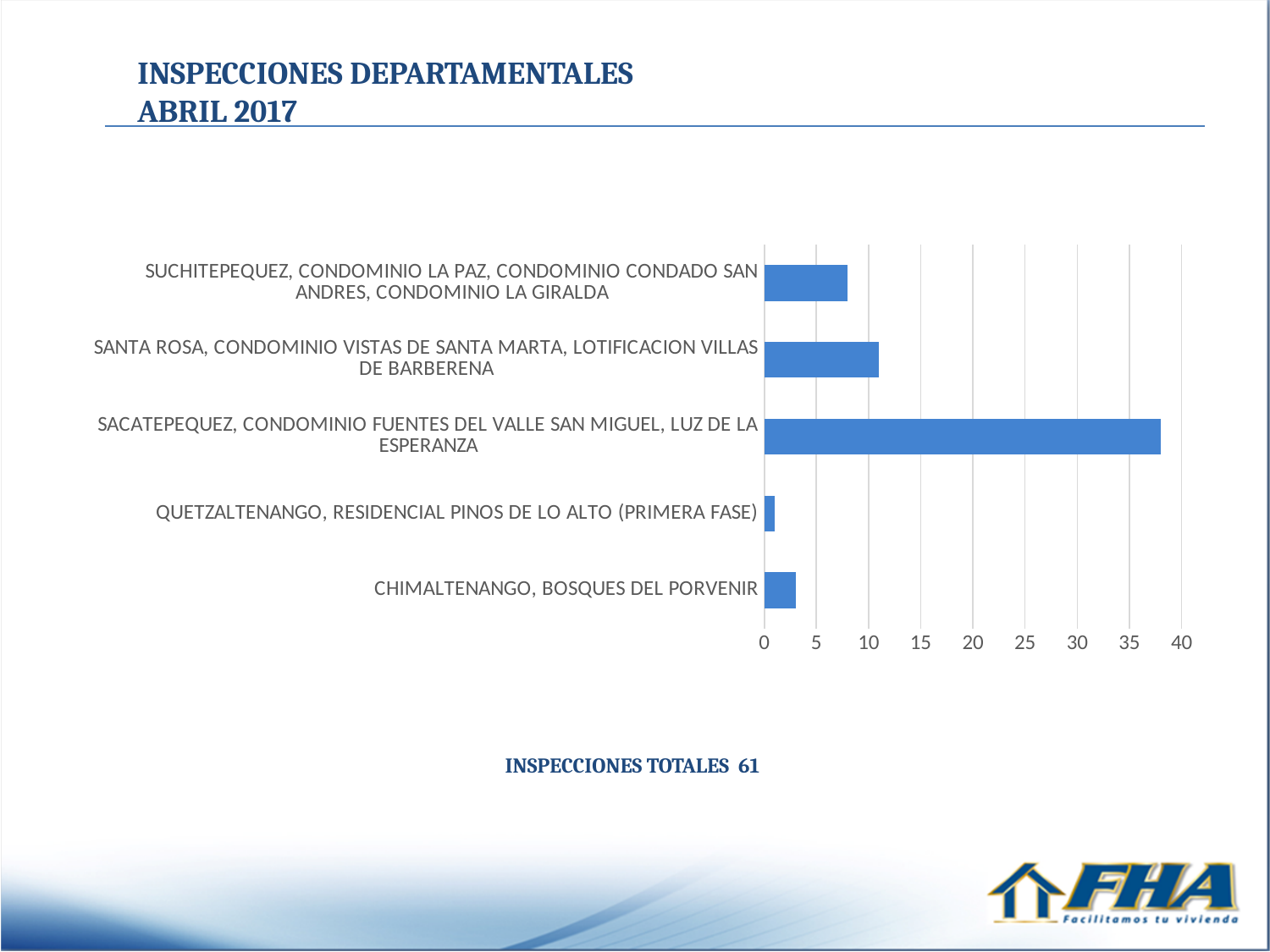
What total number of inspections is stated below the chart? 61 Which has a larger value: CHIMALTENANGO, BOSQUES DEL PORVENIR or QUETZALTENANGO, RESIDENCIAL PINOS DE LO ALTO (PRIMERA FASE)? CHIMALTENANGO, BOSQUES DEL PORVENIR Is the value for SACATEPEQUEZ, CONDOMINIO FUENTES DEL VALLE SAN MIGUEL, LUZ DE LA ESPERANZA greater or less than 35? greater Which category has the lowest value in the chart? QUETZALTENANGO, RESIDENCIAL PINOS DE LO ALTO (PRIMERA FASE) What is the title of the slide containing the chart? INSPECCIONES DEPARTAMENTALES ABRIL 2017 Is the value for CHIMALTENANGO, BOSQUES DEL PORVENIR greater or less than 5? less Which category has the highest value in the chart? SACATEPEQUEZ, CONDOMINIO FUENTES DEL VALLE SAN MIGUEL, LUZ DE LA ESPERANZA Which has a larger value: SANTA ROSA, CONDOMINIO VISTAS DE SANTA MARTA, LOTIFICACION VILLAS DE BARBERENA or SUCHITEPEQUEZ, CONDOMINIO LA PAZ, CONDOMINIO CONDADO SAN ANDRES, CONDOMINIO LA GIRALDA? SANTA ROSA, CONDOMINIO VISTAS DE SANTA MARTA, LOTIFICACION VILLAS DE BARBERENA Is the value for SUCHITEPEQUEZ, CONDOMINIO LA PAZ, CONDOMINIO CONDADO SAN ANDRES, CONDOMINIO LA GIRALDA greater or less than 10? less What kind of chart is shown on the slide? bar chart How many categories are plotted in the chart? 5